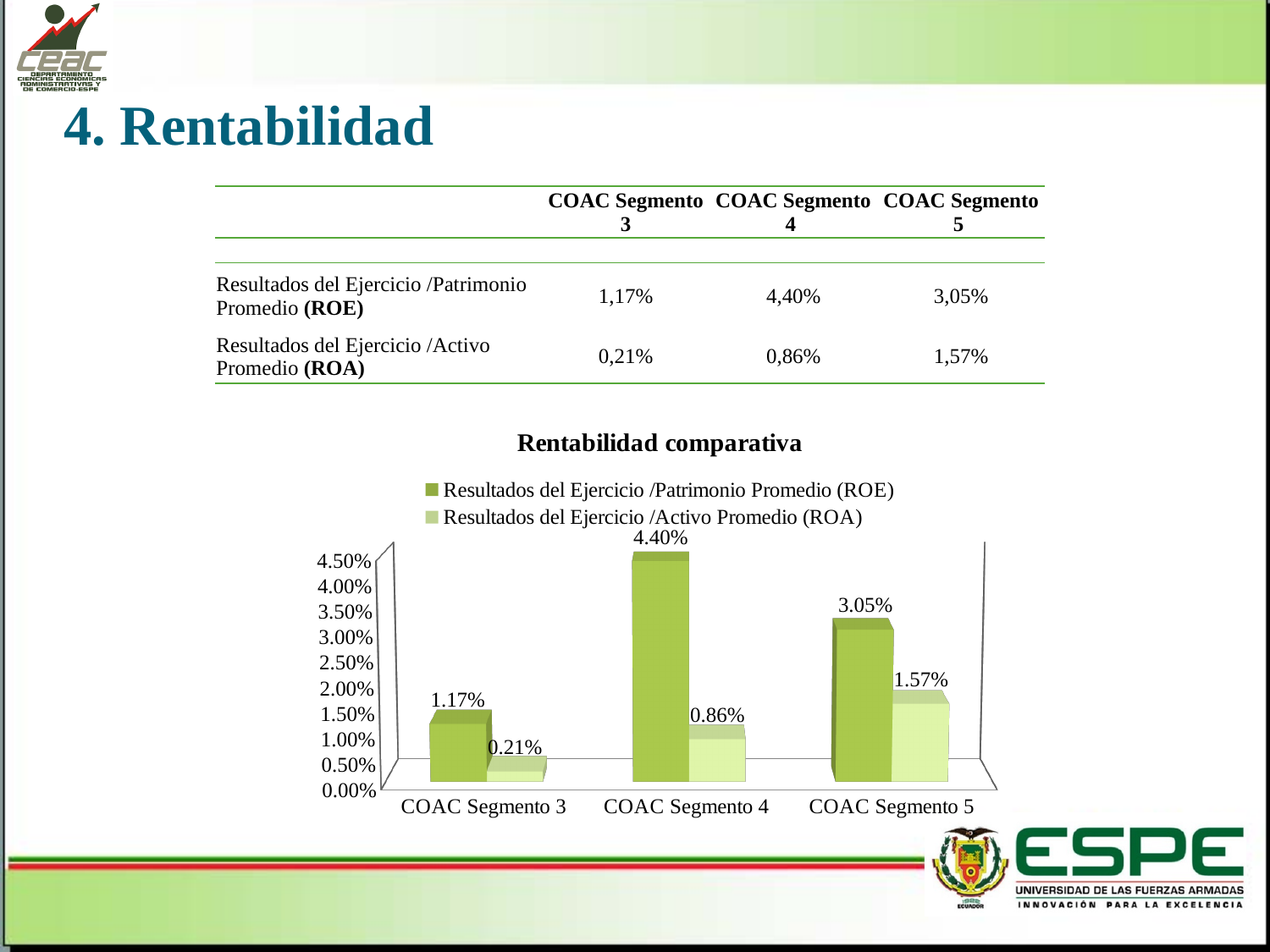
Which is larger: the ROE for COAC Segmento 3 or the ROA for COAC Segmento 5? ROA for COAC Segmento 5 Which segment has the highest ROE in the chart? COAC Segmento 4 What kind of chart is shown on the slide? Bar chart How many series does the chart legend list? 2 What is the ROE value for COAC Segmento 4 in the chart? 4.40% Which segment has the lowest ROA in the chart? COAC Segmento 3 What is the ROA value for COAC Segmento 5 in the chart? 1.57% What is the title of the chart? Rentabilidad comparativa What is the difference between the ROE and ROA values for COAC Segmento 5? 1.48% What is the ROA value for COAC Segmento 3 in the chart? 0.21% How many segments are shown on the x axis of the chart? 3 Is the ROE value for COAC Segmento 5 greater or less than 2.50%? greater